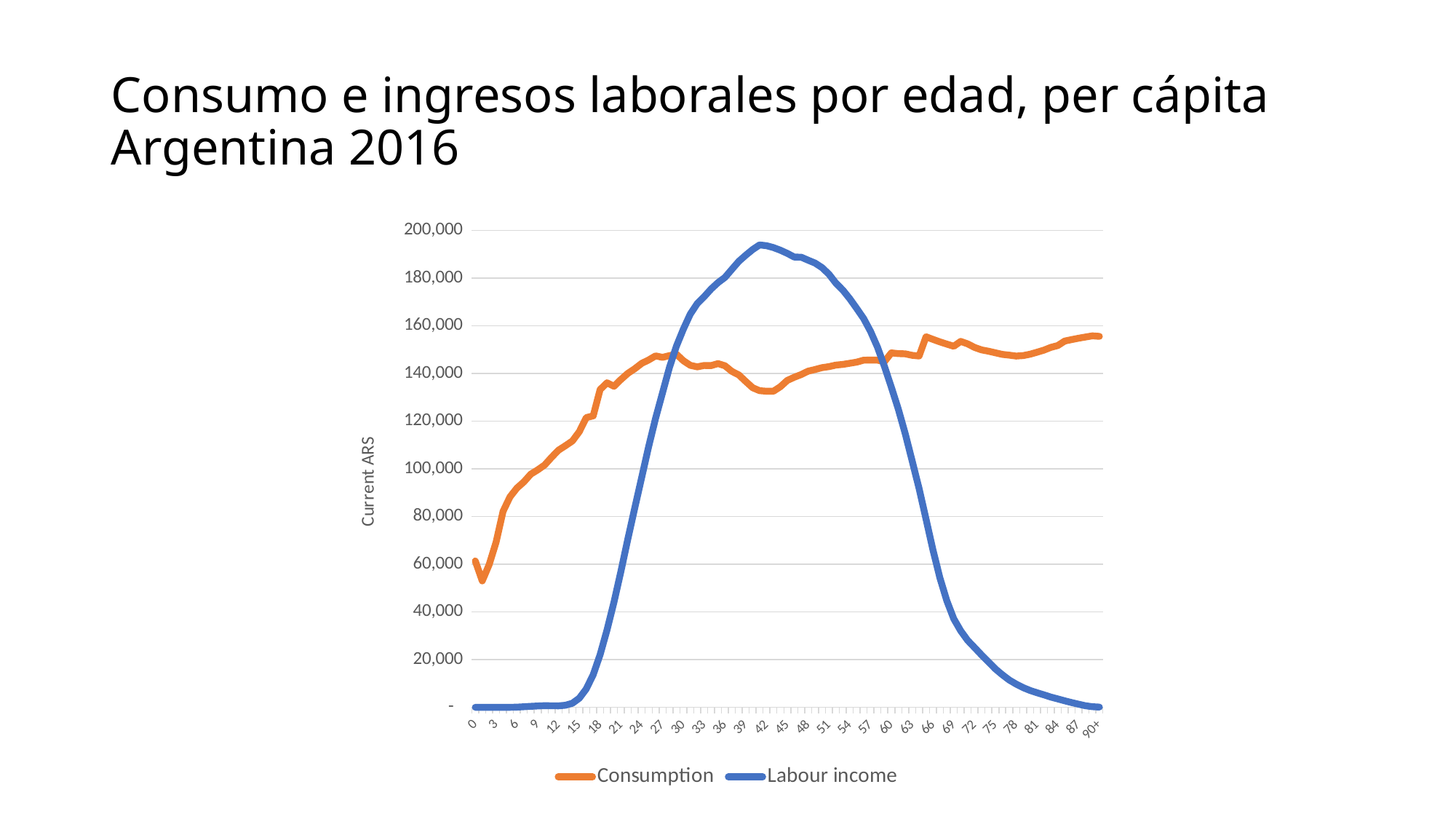
Is the value of Labour income at age 42 greater or less than 180,000? greater Does Labour income rise or fall between age 42 and age 90+? fall Is the value of Consumption at age 0 greater or less than 80,000? less Is the value of Consumption at age 90+ greater or less than 140,000? greater What are the two series named in the legend? Consumption and Labour income What kind of chart is shown on the slide? line chart What is the title of the vertical axis? Current ARS At age 42, which series has the higher value, Consumption or Labour income? Labour income How many series does the legend list? 2 At age 75, which series has the higher value, Consumption or Labour income? Consumption